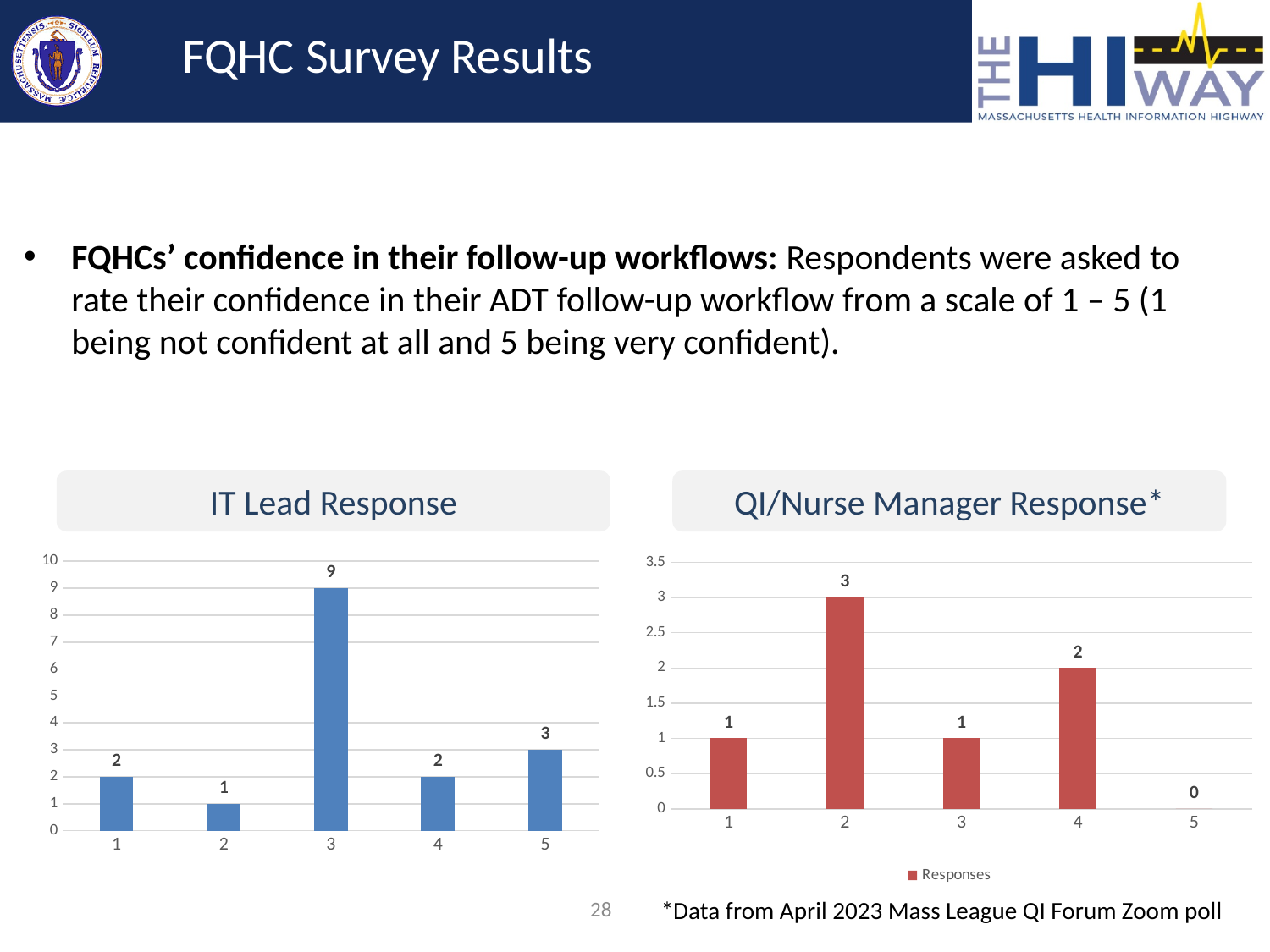
In the IT Lead Response chart, what is the total of all the bar values? 17 In the IT Lead Response chart, what is the value for rating 3? 9 In the IT Lead Response chart, what is the difference between the values for rating 3 and rating 5? 6 In the IT Lead Response chart, is the value for rating 3 greater or less than 5? greater In the IT Lead Response chart, which rating has the highest value? 3 What is the legend entry shown below the QI/Nurse Manager Response chart? Responses How many series does the legend of the QI/Nurse Manager Response chart list? 1 In the QI/Nurse Manager Response chart, which rating has the lowest value? 5 How many rating categories are shown on the x axis of the QI/Nurse Manager Response chart? 5 What kind of chart is the IT Lead Response chart? bar chart In the QI/Nurse Manager Response chart, what is the value for rating 2? 3 In the QI/Nurse Manager Response chart, which is larger, the value for rating 2 or the value for rating 4? rating 2